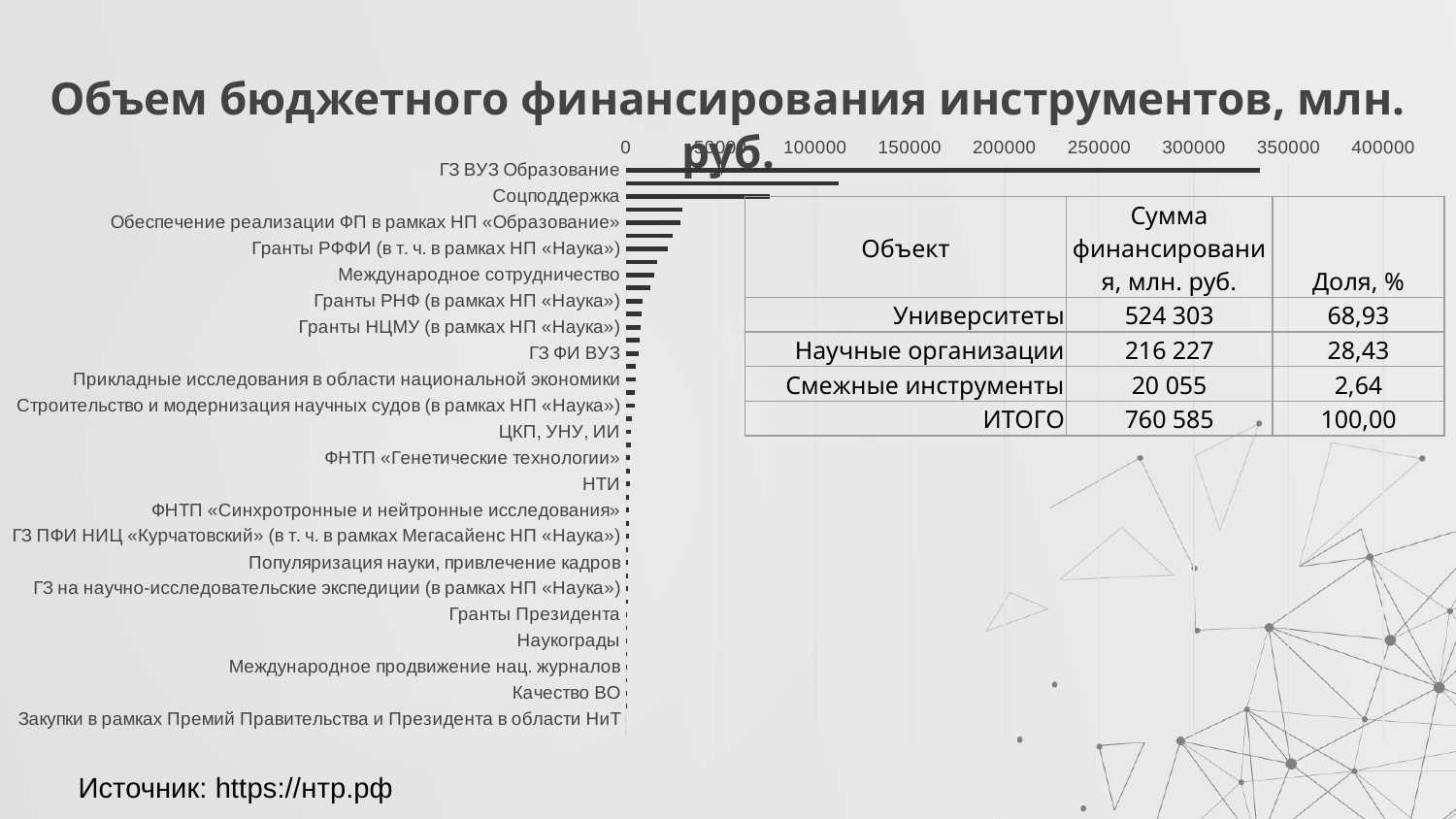
Is the value for ГЗ ВУЗ Образование greater or less than 300000? greater Is the value for Обеспечение реализации ФП в рамках НП «Образование» greater or less than 50000? less Is the value for Соцподдержка greater or less than 100000? less Do the bar values increase or decrease going from the top category to the bottom category? decrease What is the title of the chart? Объем бюджетного финансирования инструментов, млн. руб. How many categories are plotted in the chart? 44 Which category has the highest value in the chart? ГЗ ВУЗ Образование Which is larger, the value for ГЗ ВУЗ Образование or the value for Соцподдержка? ГЗ ВУЗ Образование What kind of chart is shown on the slide? bar chart Which is larger, the value for Соцподдержка or the value for Гранты РФФИ (в т. ч. в рамках НП «Наука»)? Соцподдержка